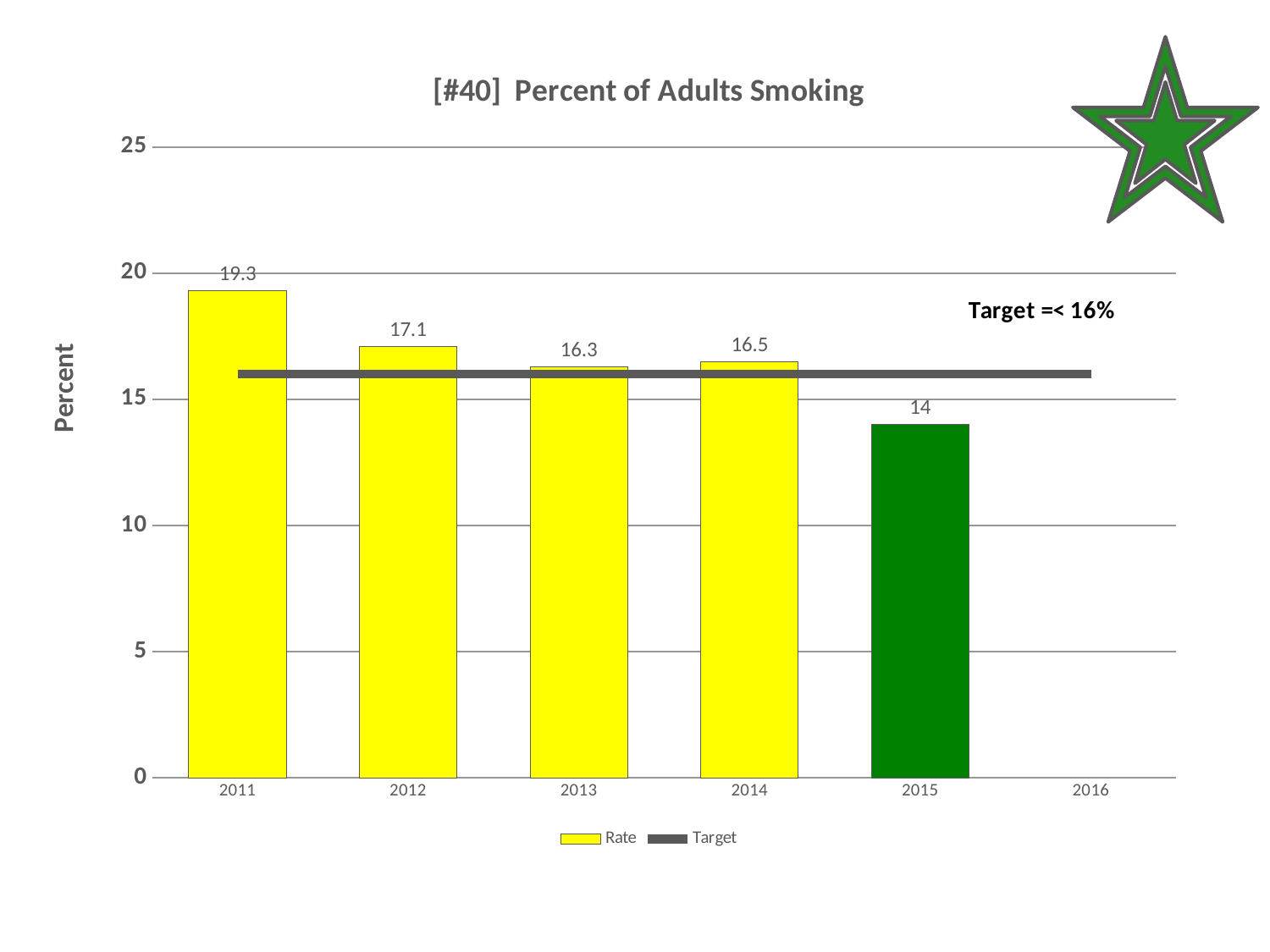
Which year has the lowest percent of adults smoking? 2015 How many series does the legend list? 2 Which is larger, the value for 2012 or the value for 2014? 2012 Is the value for 2015 greater or less than 15? less What is the target stated on the slide? =< 16% What is the percent of adults smoking in 2011? 19.3 Which year has the highest percent of adults smoking? 2011 What is the value for 2013? 16.3 What is the difference between the 2011 and 2015 values? 5.3 What is the percent of adults smoking in 2015? 14 How many years are labelled on the x axis? 6 What kind of chart is shown? combination bar and line chart